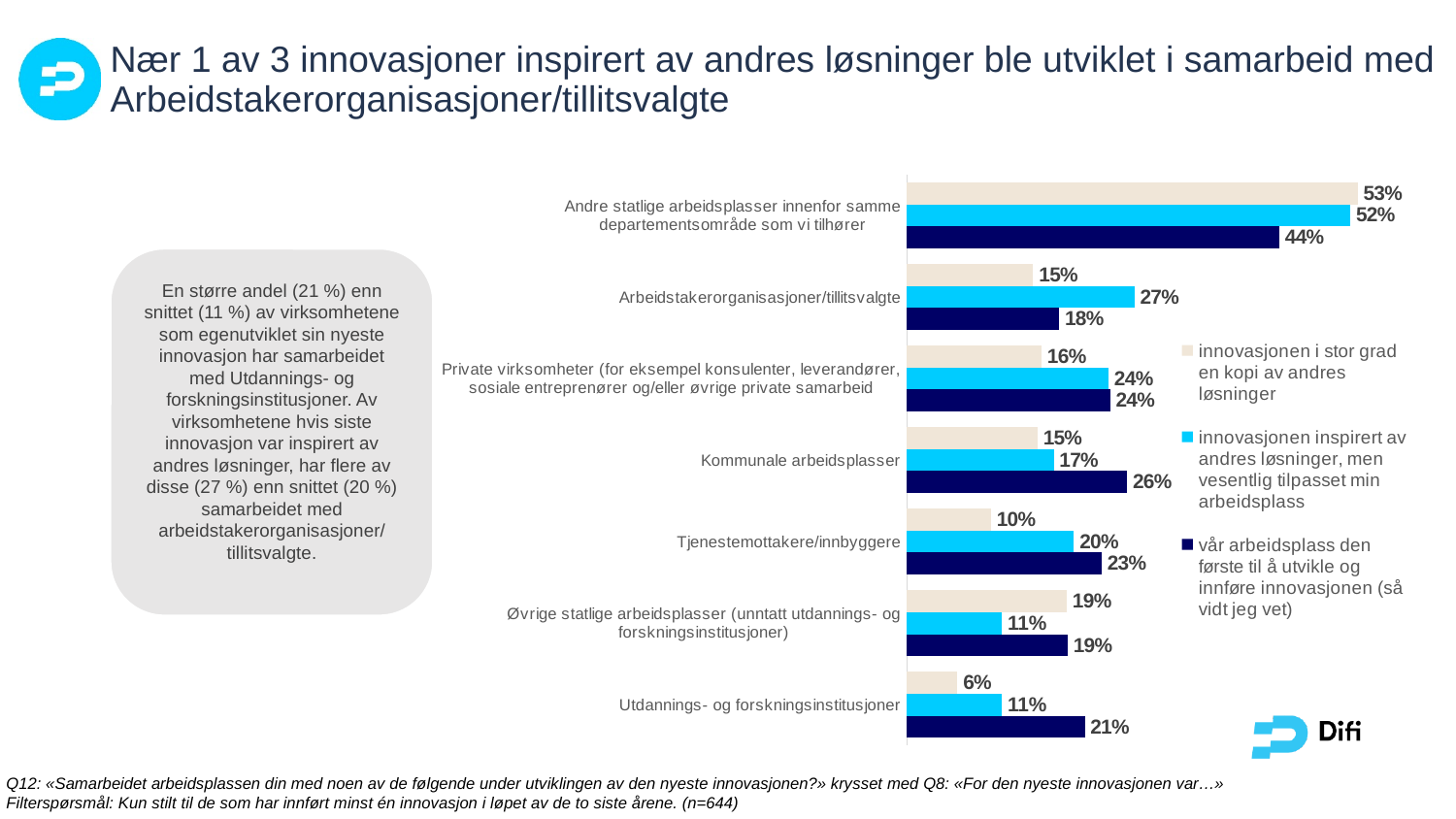
How many categories are shown on the chart? 7 What kind of chart is shown on the slide? Bar chart What is the value for Kommunale arbeidsplasser in the series 'vår arbeidsplass den første til å utvikle og innføre innovasjonen (så vidt jeg vet)'? 26% What is the value for Øvrige statlige arbeidsplasser (unntatt utdannings- og forskningsinstitusjoner) in the series 'innovasjonen inspirert av andres løsninger, men vesentlig tilpasset min arbeidsplass'? 11% What is the value for Utdannings- og forskningsinstitusjoner in the series 'innovasjonen i stor grad en kopi av andres løsninger'? 6% Which category has the highest value in the series 'innovasjonen i stor grad en kopi av andres løsninger'? Andre statlige arbeidsplasser innenfor samme departementsområde som vi tilhører How many series does the legend list? 3 Which colour represents the series 'vår arbeidsplass den første til å utvikle og innføre innovasjonen (så vidt jeg vet)'? Dark blue For Tjenestemottakere/innbyggere, which series has the larger value: 'innovasjonen inspirert av andres løsninger, men vesentlig tilpasset min arbeidsplass' or 'vår arbeidsplass den første til å utvikle og innføre innovasjonen (så vidt jeg vet)'? vår arbeidsplass den første til å utvikle og innføre innovasjonen (så vidt jeg vet) What is the value for Arbeidstakerorganisasjoner/tillitsvalgte in the series 'innovasjonen inspirert av andres løsninger, men vesentlig tilpasset min arbeidsplass'? 27% Which category has the lowest value in the series 'innovasjonen i stor grad en kopi av andres løsninger'? Utdannings- og forskningsinstitusjoner What is the difference between the 'innovasjonen inspirert av andres løsninger, men vesentlig tilpasset min arbeidsplass' value and the 'innovasjonen i stor grad en kopi av andres løsninger' value for Arbeidstakerorganisasjoner/tillitsvalgte? 12 percentage points